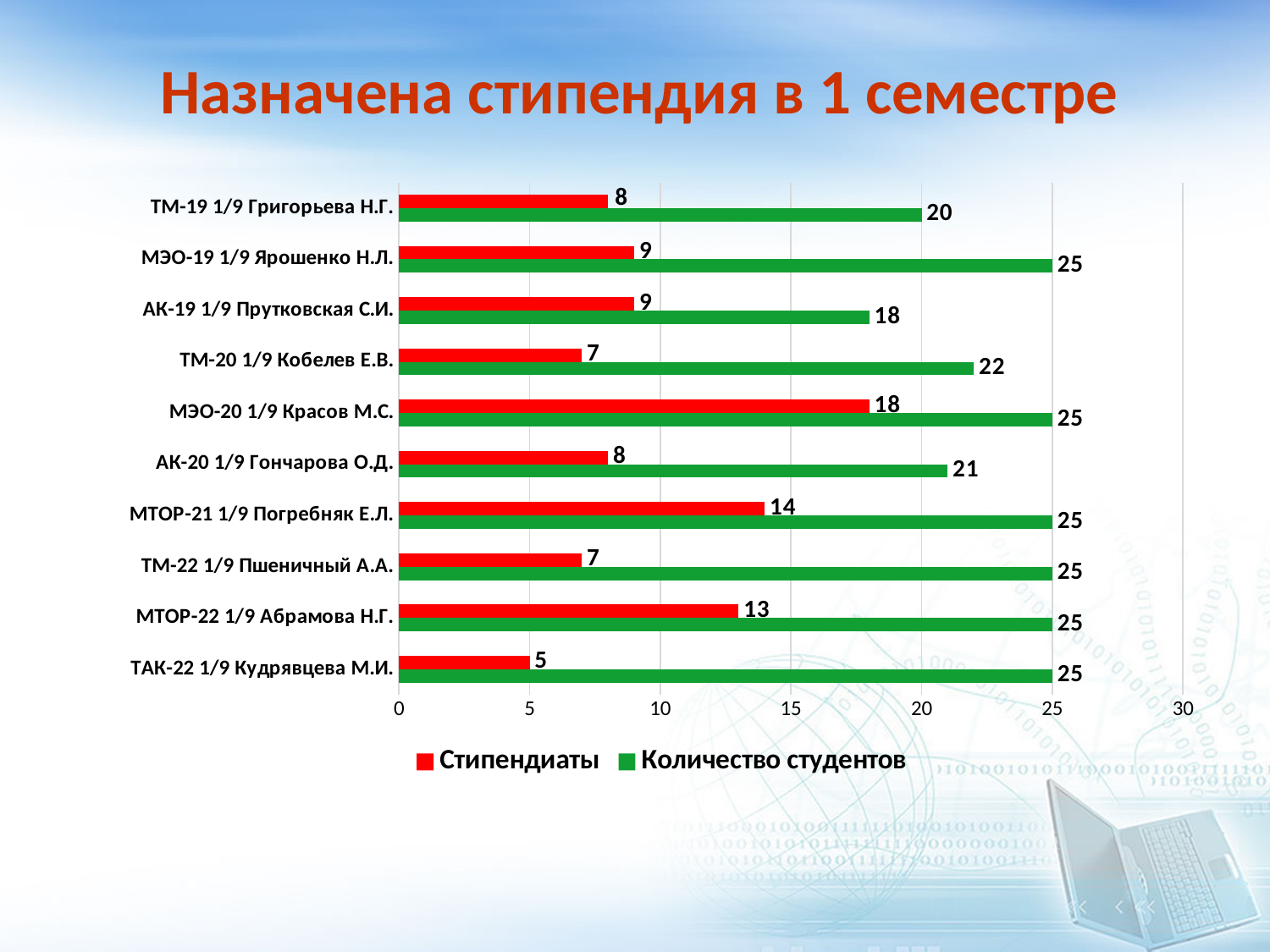
Which is larger: Стипендиаты for МТОР-22 1/9 Абрамова Н.Г. or Стипендиаты for ТМ-22 1/9 Пшеничный А.А.? МТОР-22 1/9 Абрамова Н.Г. Which category has the highest value of Стипендиаты? МЭО-20 1/9 Красов М.С. What type of chart is shown on the slide? bar chart Which category has the lowest value of Стипендиаты? ТАК-22 1/9 Кудрявцева М.И. What is the value of Стипендиаты for МЭО-20 1/9 Красов М.С.? 18 Which category has the lowest value of Количество студентов? АК-19 1/9 Прутковская С.И. How many categories are shown on the chart? 10 What is the difference between Количество студентов and Стипендиаты for МТОР-21 1/9 Погребняк Е.Л.? 11 How many series does the legend list? 2 What is the value of Стипендиаты for ТАК-22 1/9 Кудрявцева М.И.? 5 What is the value of Количество студентов for ТМ-19 1/9 Григорьева Н.Г.? 20 Is the value of Количество студентов for ТМ-20 1/9 Кобелев Е.В. greater or less than 20? greater